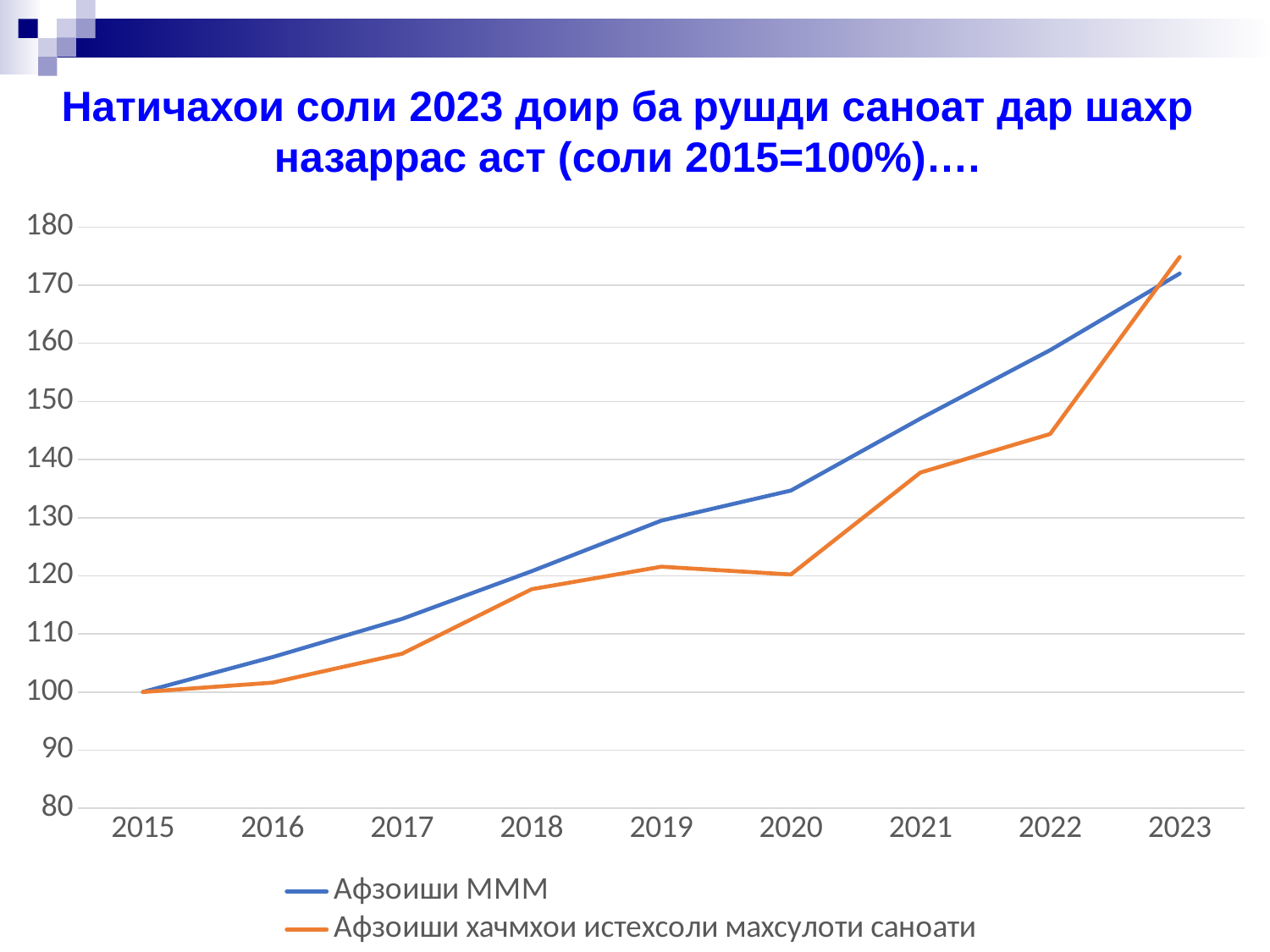
Is the value for Афзоиши ММM in 2020 greater or less than 130? greater Does the Афзоиши ММM line rise or fall from 2015 to 2023? rise In which year is Афзоиши ММM lowest? 2015 What kind of chart is shown on the slide? line chart How many years are plotted along the x axis? 9 How many series does the legend list? 2 In 2022, which series has the larger value, Афзоиши ММM or Афзоиши хачмхои истехсоли махсулоти саноати? Афзоиши ММM What is the value of Афзоиши ММM in 2015? 100 Is the value for Афзоиши хачмхои истехсоли махсулоти саноати in 2022 greater or less than 150? less Is the value for Афзоиши хачмхои истехсоли махсулоти саноати in 2021 greater or less than 140? less Which colour is used for the Афзоиши хачмхои истехсоли махсулоти саноати line? orange In which year is Афзоиши хачмхои истехсоли махсулоти саноати highest? 2023